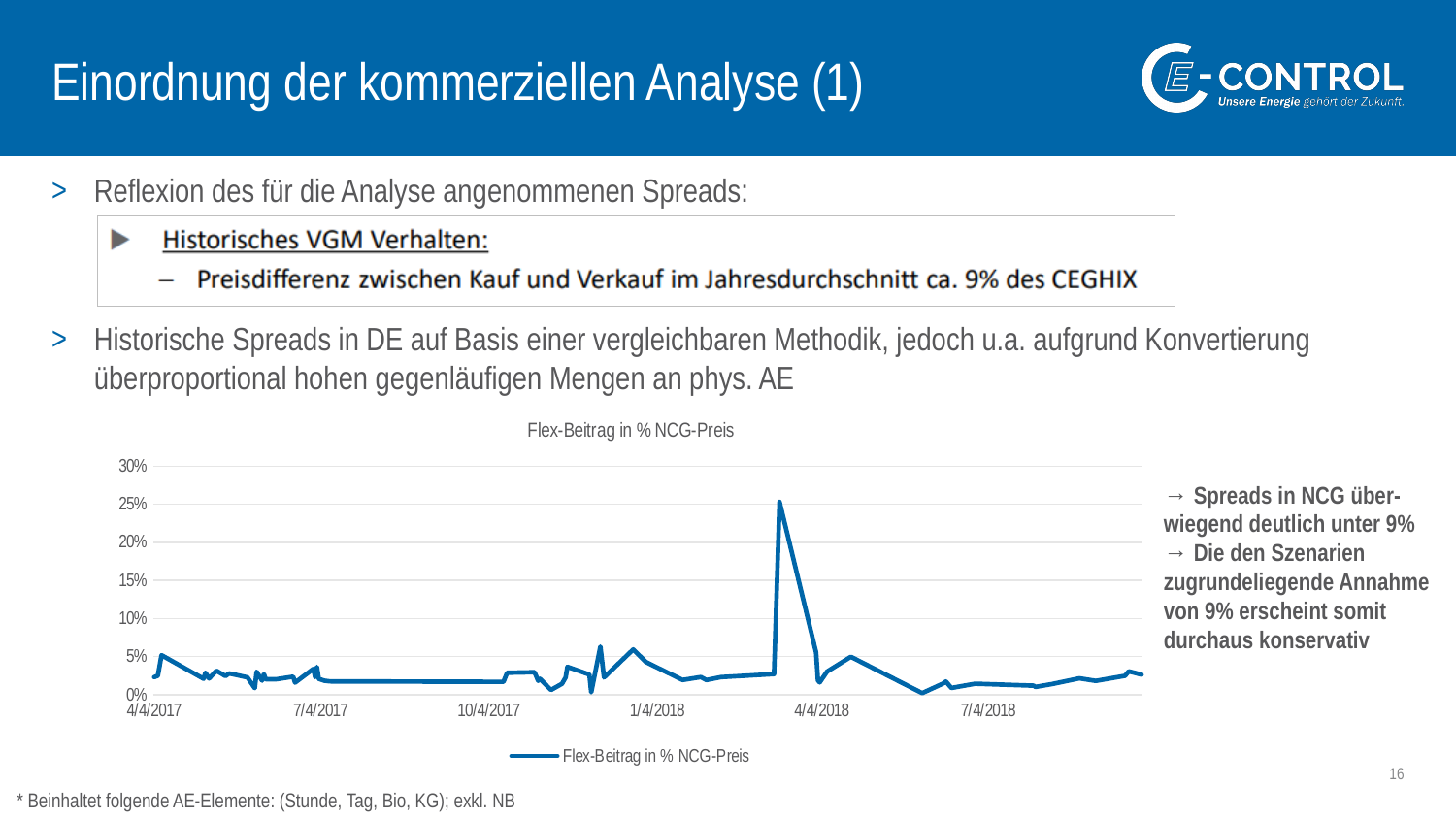
Is the peak value of the Flex-Beitrag line greater or less than 20%? greater What is the first date label on the horizontal axis of the chart? 4/4/2017 What is the title of the chart? Flex-Beitrag in % NCG-Preis How many series does the chart legend list? 1 What is the highest value shown on the chart's vertical axis? 30% What kind of chart is shown on the slide? line chart Is the value of the Flex-Beitrag line at 7/4/2018 greater or less than 5%? less Between which two horizontal-axis labels does the sharp peak of the line occur? 1/4/2018 and 4/4/2018 How many date labels are shown on the horizontal axis of the chart? 6 Is the peak value of the Flex-Beitrag line greater or less than 30%? less